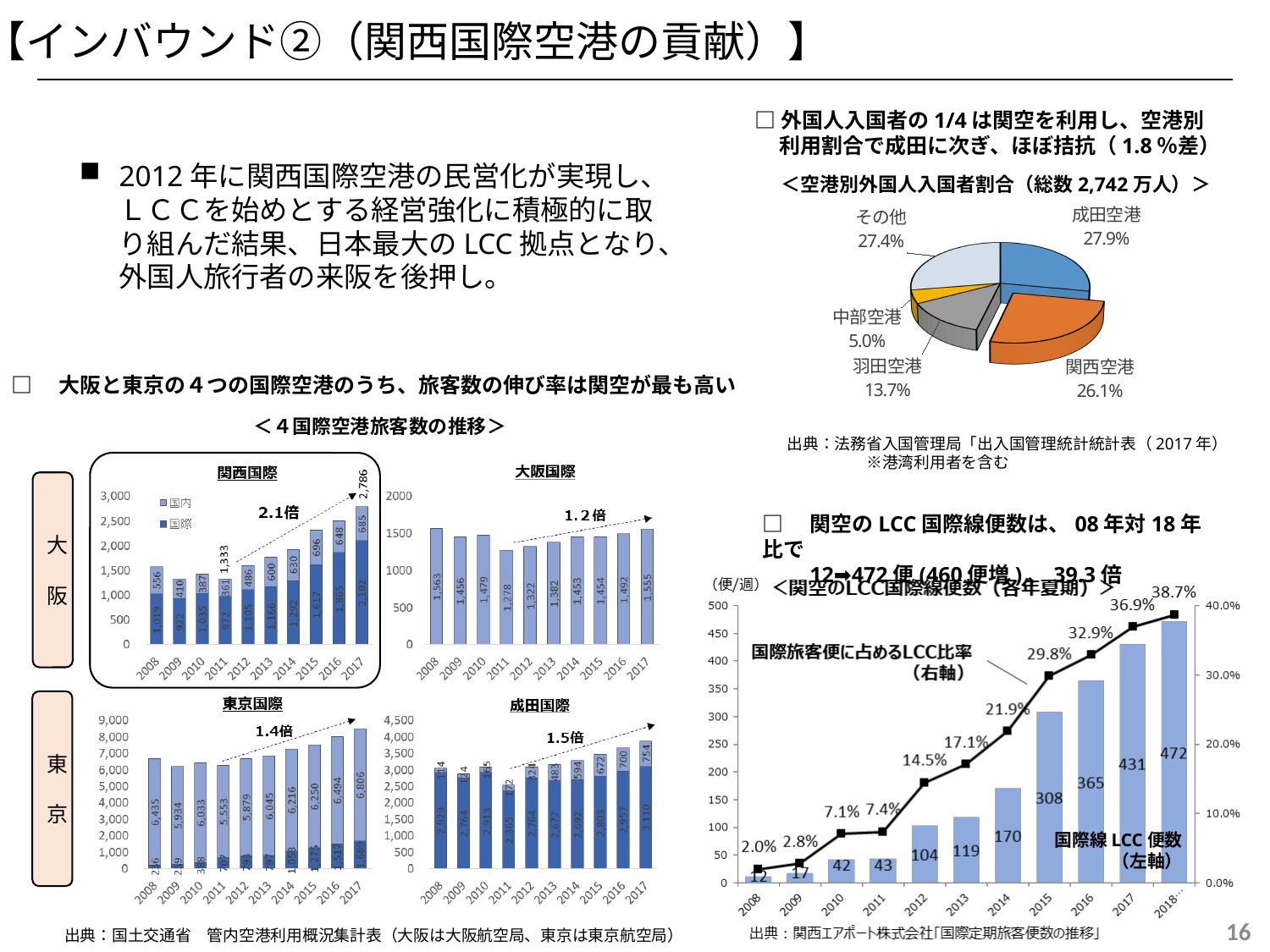
In the pie chart 空港別外国人入国者割合, what share does 成田空港 have? 27.9% In the pie chart 空港別外国人入国者割合, which airport has the smallest share? 中部空港 In the 関空のLCC国際線便数 chart, do the bar values rise or fall from 2008 to 2018? rise In the pie chart 空港別外国人入国者割合, what is the difference between the shares of 成田空港 and 関西空港? 1.8% In the pie chart 空港別外国人入国者割合, what share does 関西空港 have? 26.1% In the pie chart 空港別外国人入国者割合, how many slices are there? 5 In the 関空のLCC国際線便数 chart, what is the number of LCC international flights (bar) for 2018? 472 In the 関西国際 chart, what is the total passenger number labeled for 2017? 2,786 In the 関空のLCC国際線便数 chart, how many years are plotted on the x axis? 11 In the 大阪国際 chart, what is the value for 2011? 1,278 In the 関空のLCC国際線便数 chart, what is the LCC share (line) for 2015? 29.8% In the 関空のLCC国際線便数 chart, what is the difference between the bar values for 2018 and 2008? 460